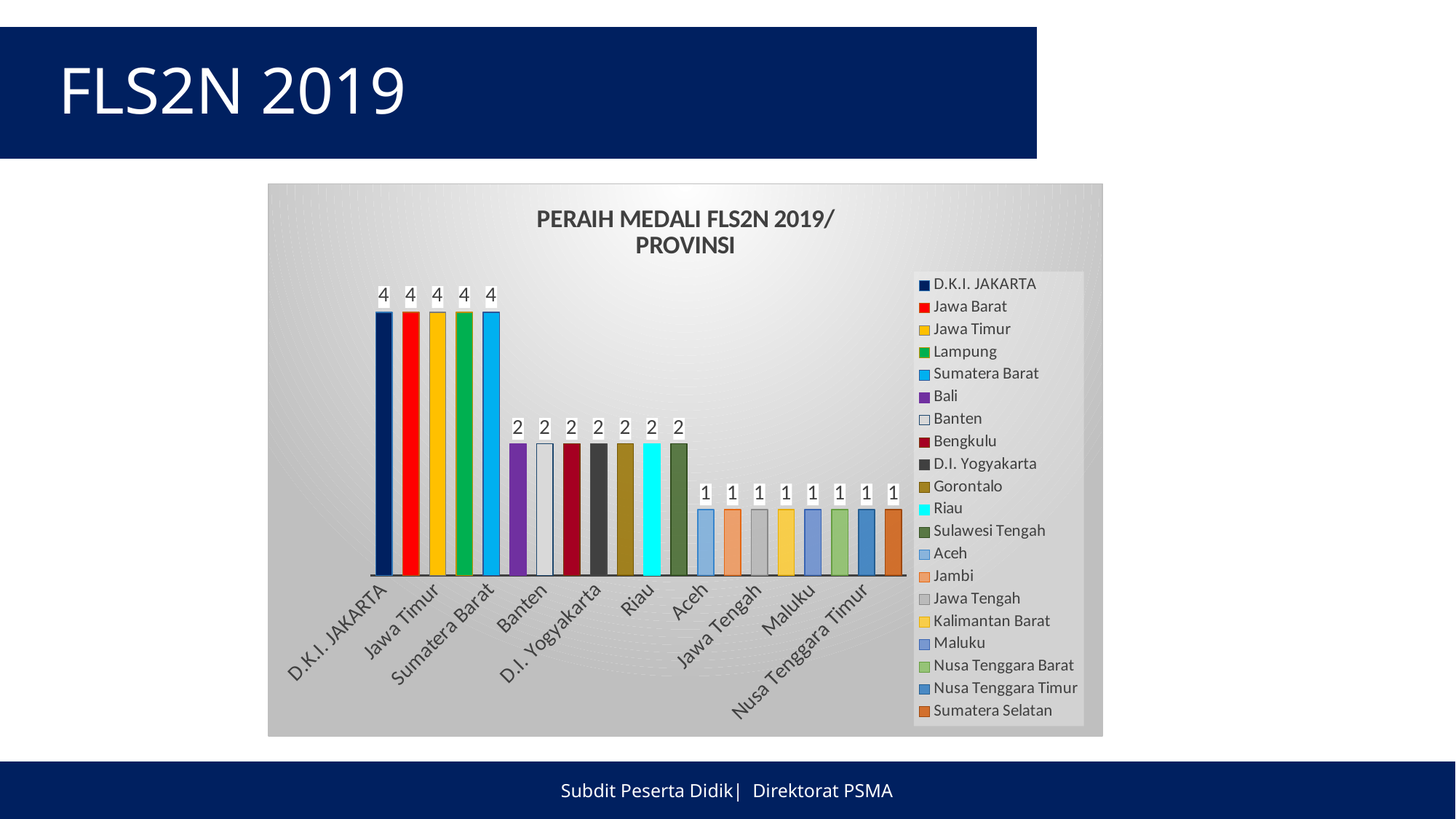
What is the value for Nusa Tenggara Timur? 1 Which has the larger value, Riau or Maluku? Riau Which has the larger value, Jawa Timur or Banten? Jawa Timur What is the value for Riau? 2 What is the value for Aceh? 1 What is the difference between the values for D.K.I. JAKARTA and Aceh? 3 How many entries does the legend list? 20 How many bars are plotted in the chart? 20 What is the value for D.K.I. JAKARTA? 4 What is the value for Banten? 2 What kind of chart is shown on the slide? Bar chart What is the difference between the values for Sumatera Barat and D.I. Yogyakarta? 2